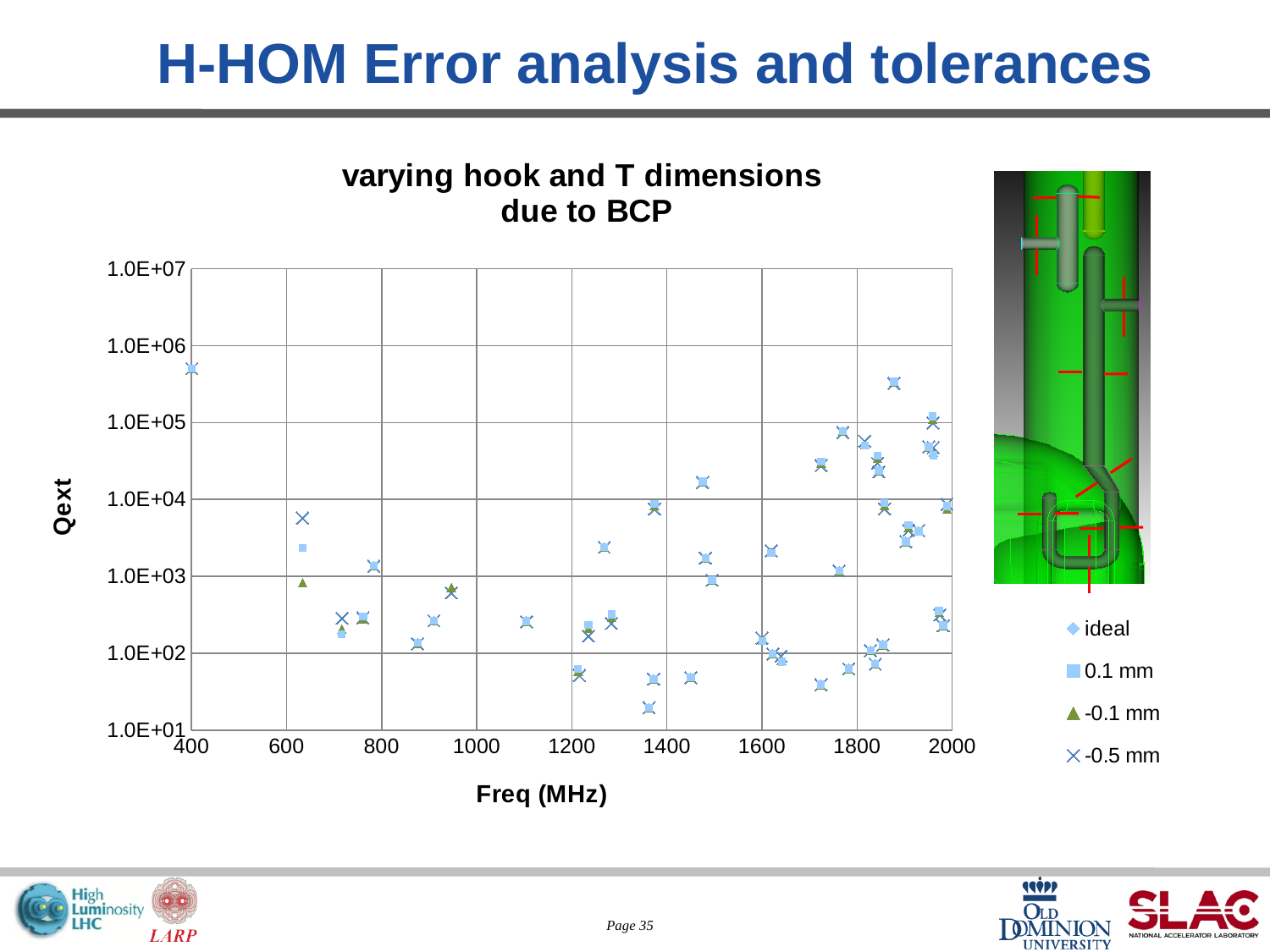
Is the Qext value of the points near 400 MHz greater or less than 1.0E+06? less Is the Qext value of the highest points near 1880 MHz greater or less than 1.0E+05? greater Is the Qext value of the lowest points near 1360 MHz greater or less than 1.0E+02? less How many series does the chart legend list? 4 What is the label of the x axis of the chart? Freq (MHz) What is the title of the chart? varying hook and T dimensions due to BCP What kind of chart is shown on the slide? scatter chart